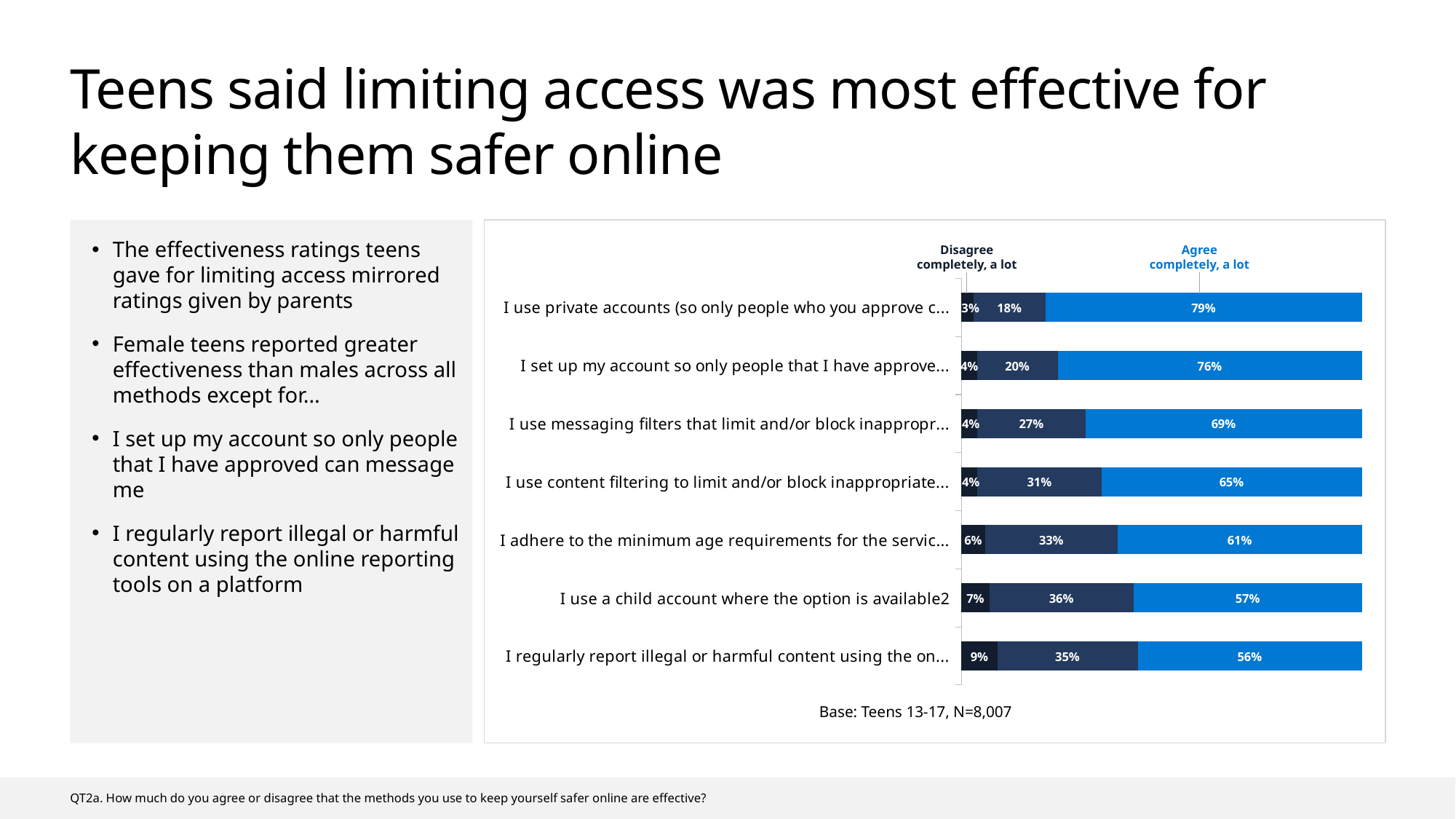
What is the difference in 'Agree completely, a lot' percentage between using private accounts and using a child account? 22 percentage points What percentage of teens disagree completely or a lot that regularly reporting illegal or harmful content is effective? 9% Which method has the highest 'Agree completely, a lot' percentage? I use private accounts What is the middle (unlabelled) segment value for 'I use a child account where the option is available'? 36% What percentage of teens agree completely or a lot that using private accounts is effective? 79% Which method has the lowest 'Agree completely, a lot' percentage? I regularly report illegal or harmful content What percentage of teens agree completely or a lot that content filtering is effective? 65% What type of chart is shown on the slide? Stacked bar chart Which method has the highest 'Disagree completely, a lot' percentage? I regularly report illegal or harmful content What is the base (sample) described below the chart? Teens 13-17, N=8,007 How many methods are listed in the chart? 7 Which has a larger 'Agree completely, a lot' share: messaging filters or adhering to minimum age requirements? Messaging filters